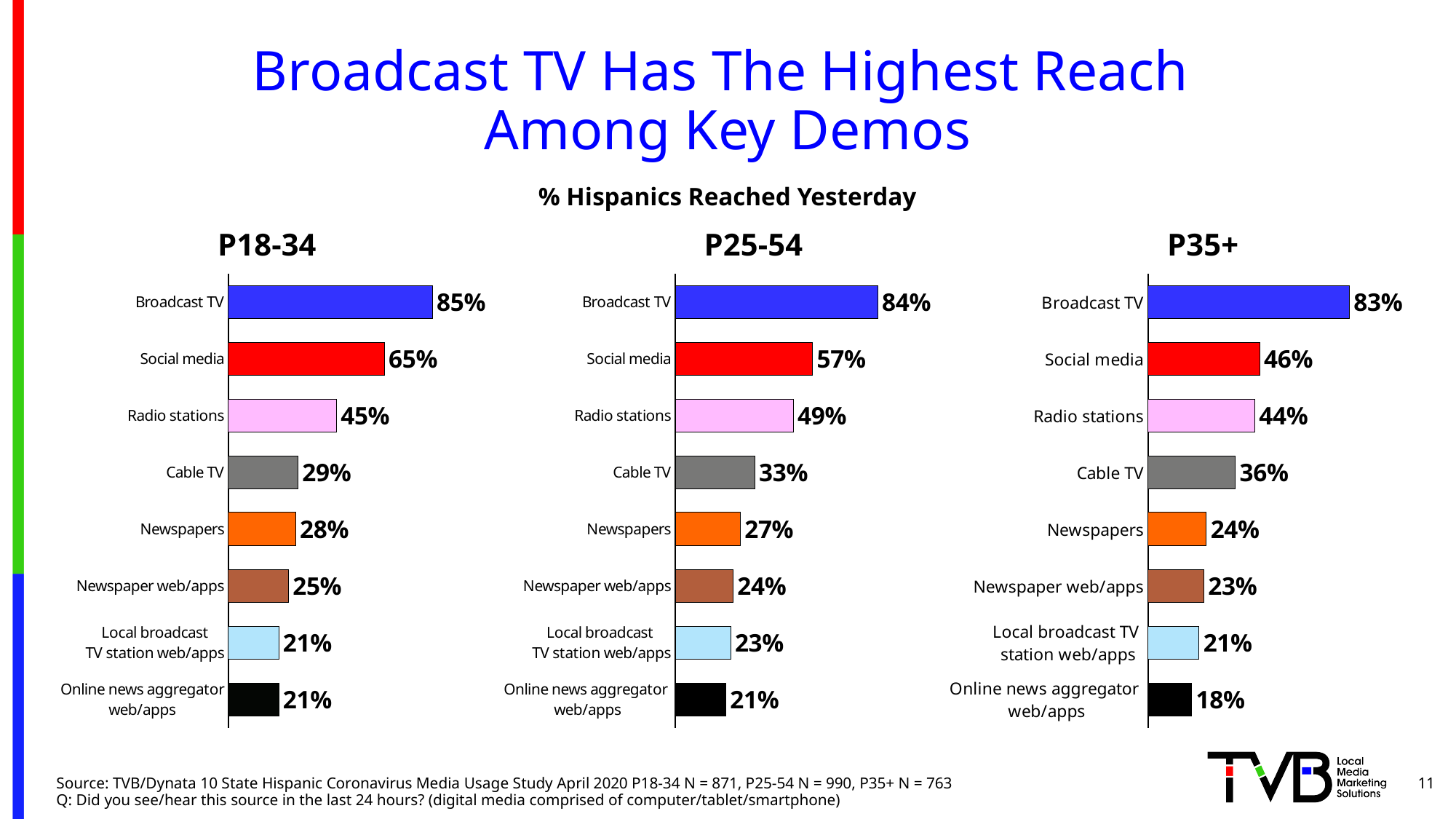
What is the subtitle shown above the three charts? % Hispanics Reached Yesterday In the P25-54 chart, what is the value for Radio stations? 49% How many categories are shown in the P18-34 chart? 8 In the P25-54 chart, which is larger: Cable TV or Newspapers? Cable TV In the P25-54 chart, what is the value for Local broadcast TV station web/apps? 23% In the P35+ chart, which category has the lowest value? Online news aggregator web/apps In the P18-34 chart, what is the difference between Broadcast TV and Social media? 20% In the P35+ chart, what is the difference between Cable TV and Newspapers? 12% What type of chart is used for the P35+ data? Bar chart In the P35+ chart, what is the value for Social media? 46% In the P25-54 chart, which category has the highest value? Broadcast TV In the P18-34 chart, what percentage of Hispanics were reached yesterday by Broadcast TV? 85%